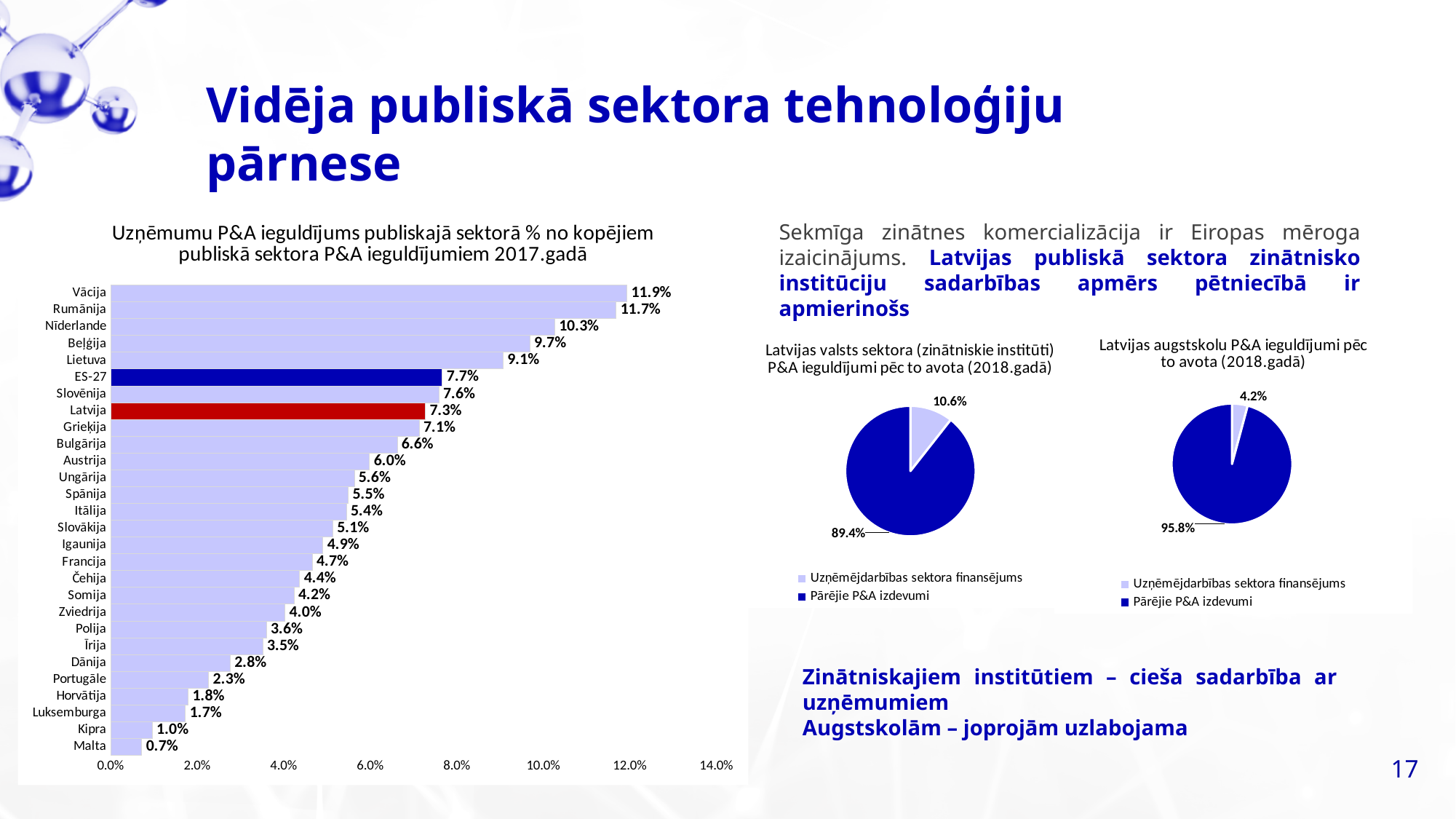
In the bar chart on the left, what is the difference between the values for Vācija and Latvija? 4.6% In the bar chart on the left, what is the value for Latvija? 7.3% In the bar chart on the left, which bar is coloured red? Latvija In the pie chart titled 'Latvijas valsts sektora (zinātniskie institūti) P&A ieguldījumi pēc to avota (2018.gadā)', what share is Uzņēmējdarbības sektora finansējums? 10.6% In the bar chart on the left, which country has the highest value? Vācija How many entries does the legend of the pie chart titled 'Latvijas augstskolu P&A ieguldījumi pēc to avota (2018.gadā)' list? 2 In the bar chart on the left, which has a larger value, Lietuva or Igaunija? Lietuva In the bar chart on the left, what is the value for ES-27? 7.7% What type of chart is the chart on the left of the slide? Bar chart In the bar chart on the left, which country has the lowest value? Malta How many countries/categories are shown in the bar chart on the left? 28 In the pie chart titled 'Latvijas augstskolu P&A ieguldījumi pēc to avota (2018.gadā)', what share is Pārējie P&A izdevumi? 95.8%